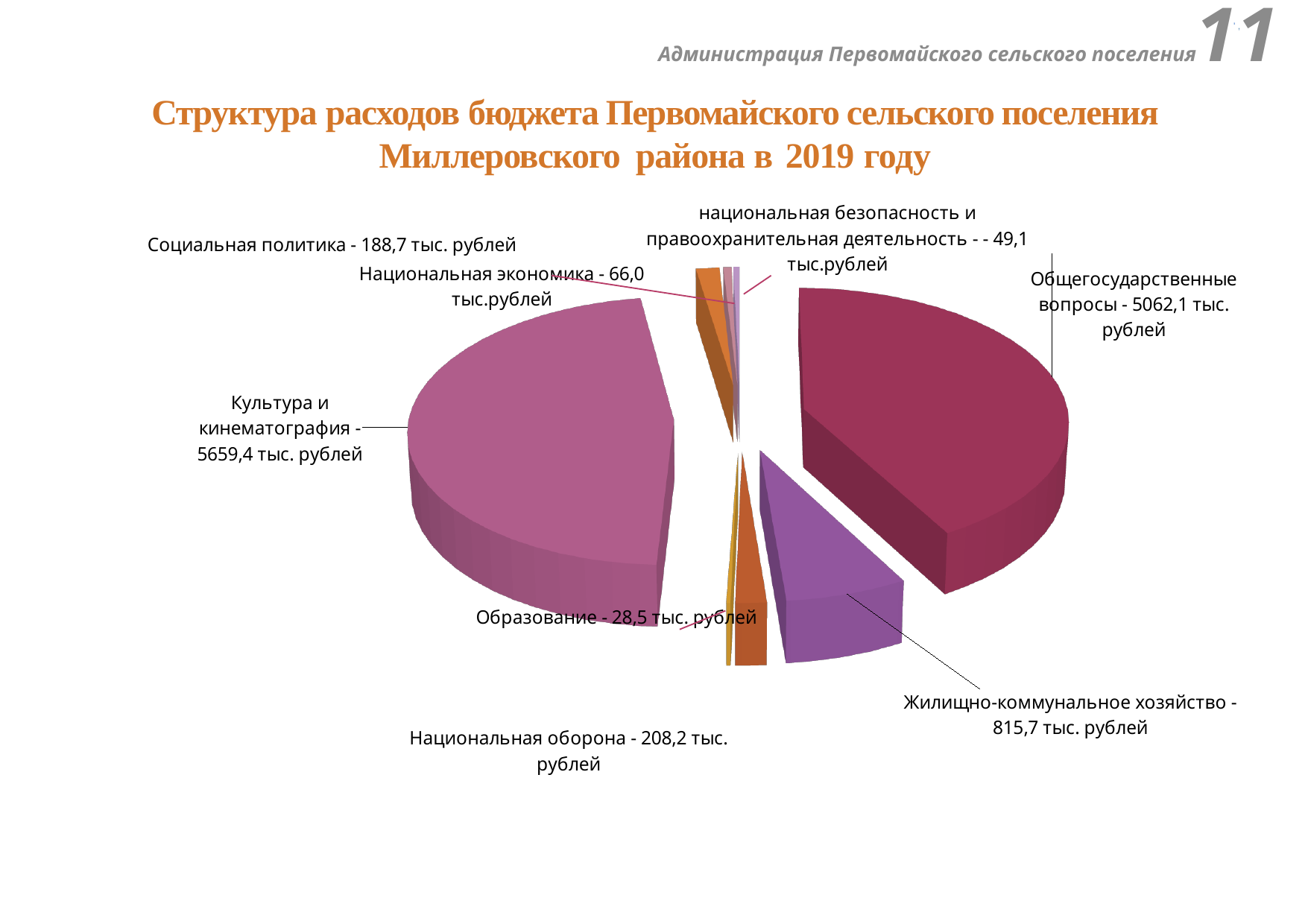
What is the value for Культура и кинематография? 5659,4 тыс. рублей What is the title of the chart on the slide? Структура расходов бюджета Первомайского сельского поселения Миллеровского района в 2019 году What is the value for Образование? 28,5 тыс. рублей How many categories (slices) does the pie chart have? 8 What kind of chart is shown on the slide? Pie chart Which category has the smallest value? Образование Which is larger: Социальная политика or Национальная экономика? Социальная политика What is the value for Жилищно-коммунальное хозяйство? 815,7 тыс. рублей What is the value for Общегосударственные вопросы? 5062,1 тыс. рублей What is the difference between Культура и кинематография and Общегосударственные вопросы? 597,3 тыс. рублей Which category has the largest value? Культура и кинематография What is the value for Национальная оборона? 208,2 тыс. рублей